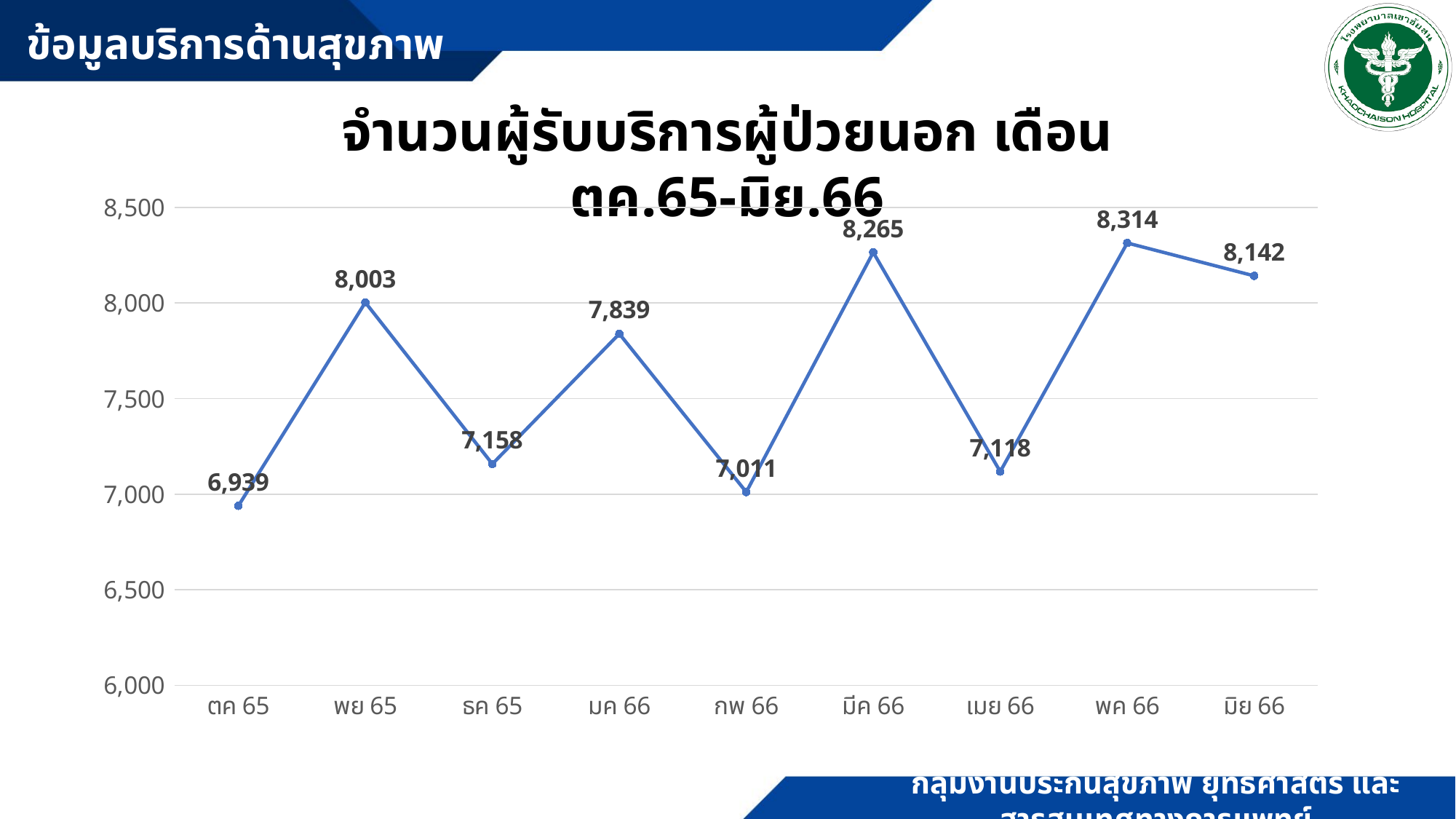
What is the title of the chart? จำนวนผู้รับบริการผู้ป่วยนอก เดือน ตค.65-มิย.66 Is the value for มค 66 greater or less than 8,000? less What is the value for ตค 65? 6,939 How many months (data points) are plotted on the chart? 9 What is the difference between the values for พย 65 and ตค 65? 1,064 What is the difference between the values for พค 66 and มีค 66? 49 Which month has the highest value? พค 66 What is the value for มิย 66? 8,142 What is the value for มีค 66? 8,265 Which is larger, the value for ธค 65 or the value for เมย 66? ธค 65 What type of chart is shown on the slide? line chart Which month has the lowest value? ตค 65